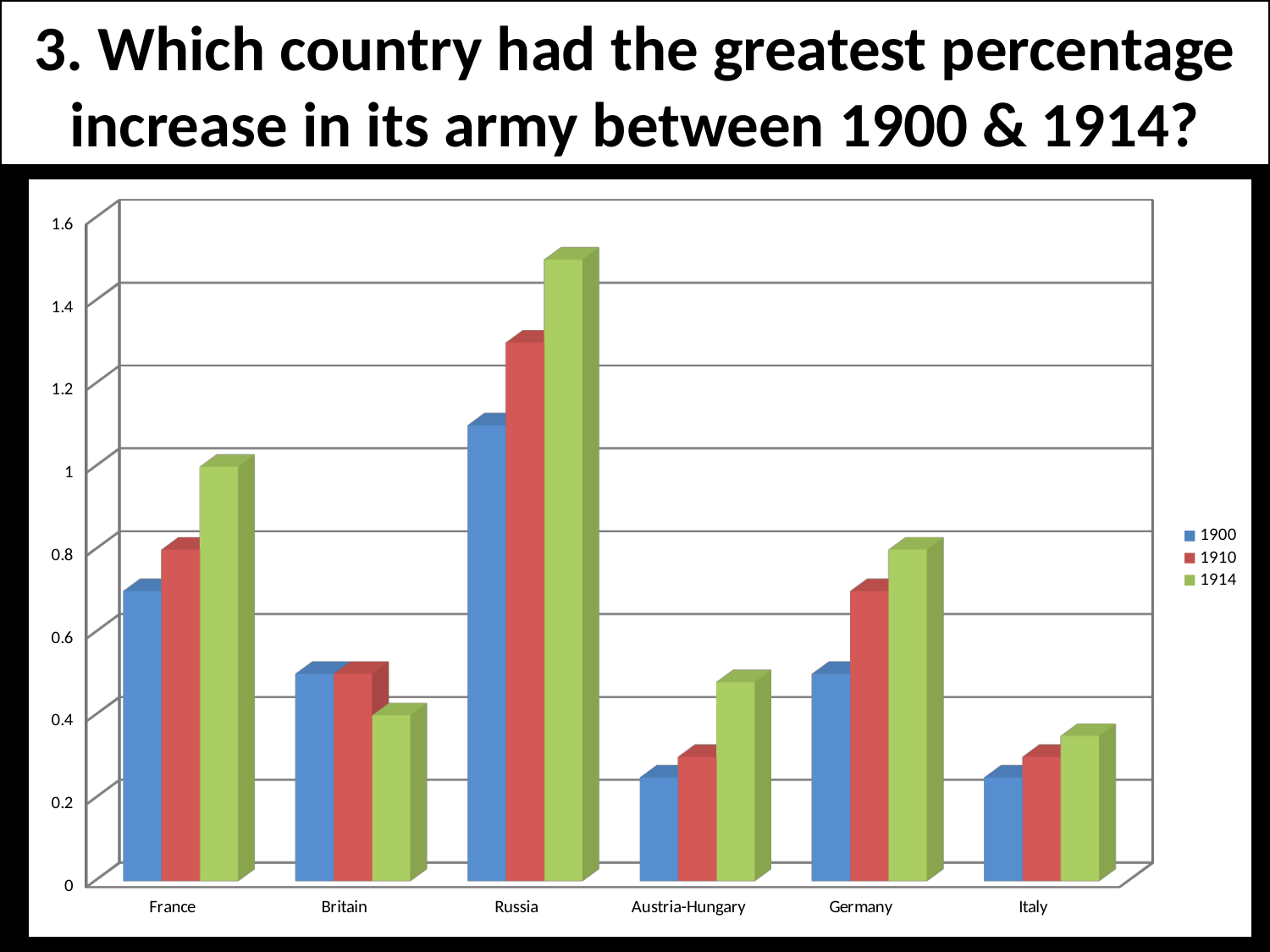
Is the 1900 value for Russia greater or less than 1? greater What kind of chart is shown on the slide? bar chart Is the 1900 value for Austria-Hungary greater or less than 0.4? less Which is larger, the 1914 value for Russia or the 1914 value for France? Russia Which country has the tallest bar for 1900? Russia Which years are listed in the chart's legend? 1900, 1910, 1914 Which country has the tallest bar for 1914? Russia How many countries are shown on the x axis of the chart? 6 How many series does the chart's legend list? 3 Is the 1914 value for Russia greater or less than 1.4? greater Do Russia's values rise or fall from 1900 to 1914? rise